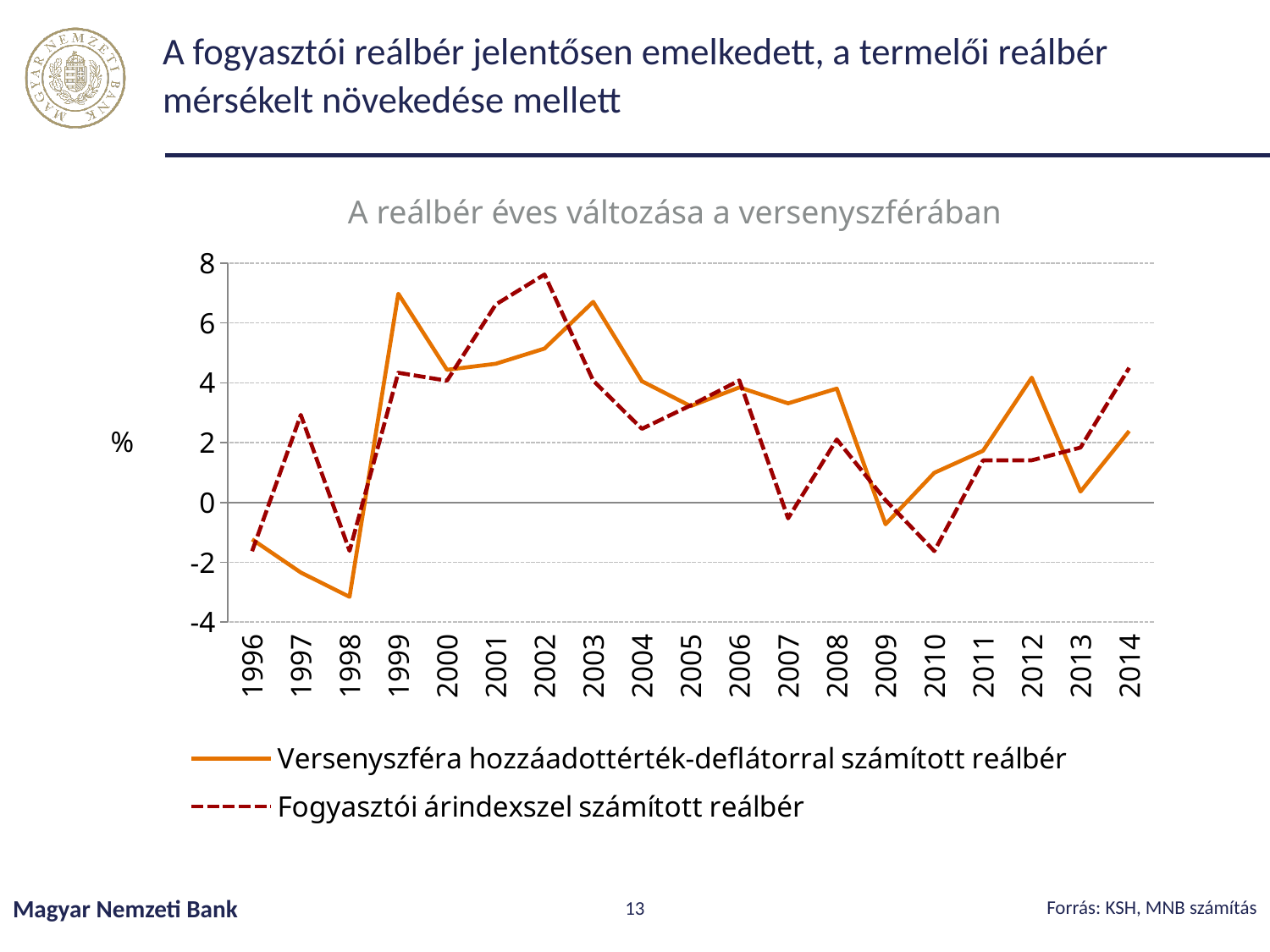
In which year does the Fogyasztói árindexszel számított reálbér series reach its highest value? 2002 Does the Versenyszféra hozzáadottérték-deflátorral számított reálbér series rise or fall from 1996 to 1998? fall How many years are shown on the x axis? 19 In 2014, which series has the larger value: Versenyszféra hozzáadottérték-deflátorral számított reálbér or Fogyasztói árindexszel számított reálbér? Fogyasztói árindexszel számított reálbér How many series does the legend list? 2 Is the value for Versenyszféra hozzáadottérték-deflátorral számított reálbér in 1998 greater or less than -2? less Which series is drawn with a dashed line? Fogyasztói árindexszel számított reálbér Is the value for Fogyasztói árindexszel számított reálbér in 2002 greater or less than 6? greater What kind of chart is shown on the slide? line chart In which year does the Versenyszféra hozzáadottérték-deflátorral számított reálbér series reach its lowest value? 1998 What is the title of the chart? A reálbér éves változása a versenyszférában In which year does the Versenyszféra hozzáadottérték-deflátorral számított reálbér series reach its highest value? 1999